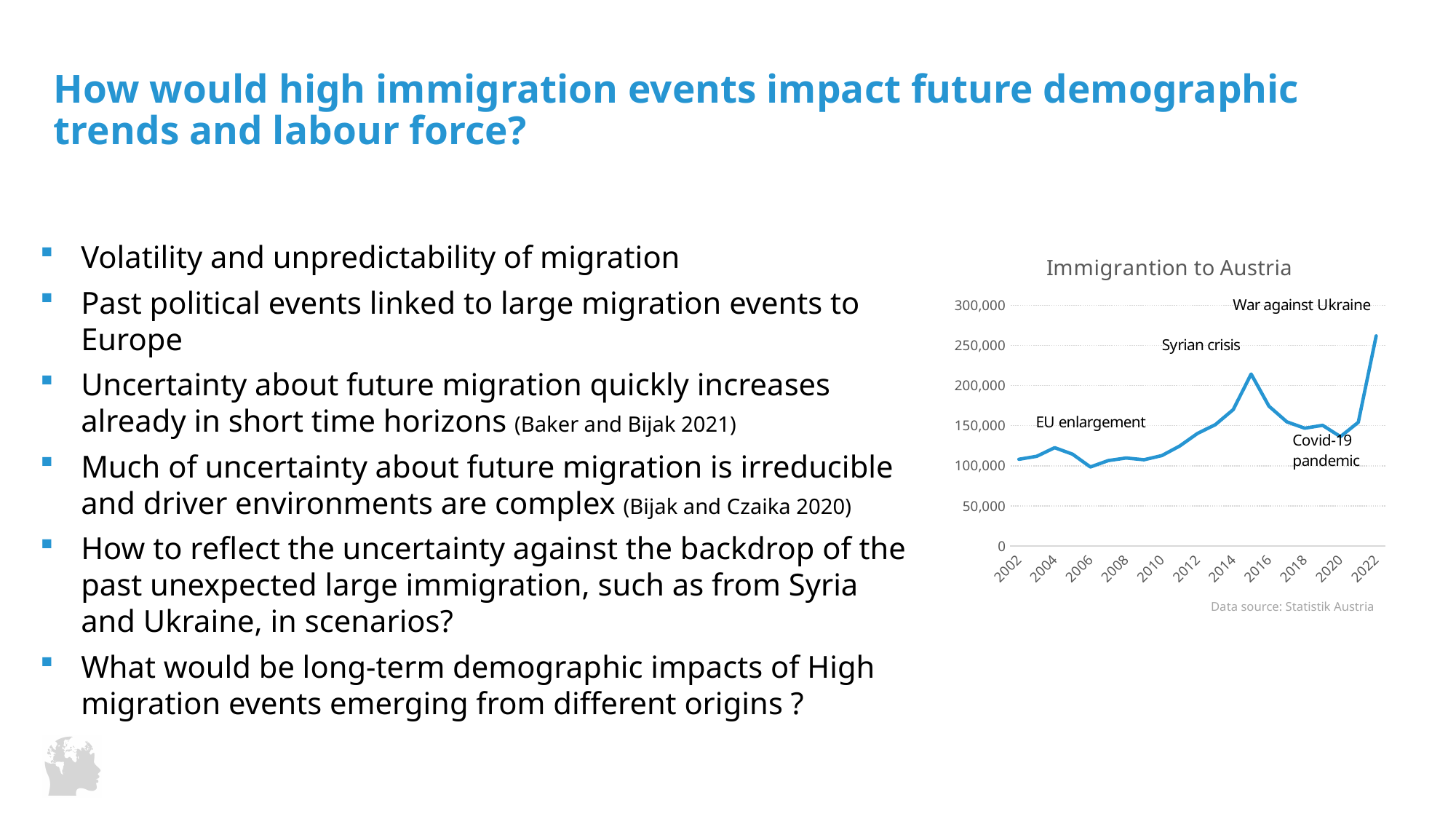
Which year has the lowest immigration value in the chart? 2006 Which year has a higher immigration value, 2015 or 2022? 2022 What kind of chart is shown on the slide? line chart Is the immigration value for 2015 greater or less than 200,000? greater Is the immigration value for 2022 greater or less than 250,000? greater Which year has a higher immigration value, 2010 or 2015? 2015 Is the immigration value for 2006 greater or less than 150,000? less What is the title of the chart? Immigrantion to Austria Does the immigration value rise or fall between 2015 and 2018? fall Which event is annotated near the peak around 2015 in the chart? Syrian crisis Which year has the highest immigration value in the chart? 2022